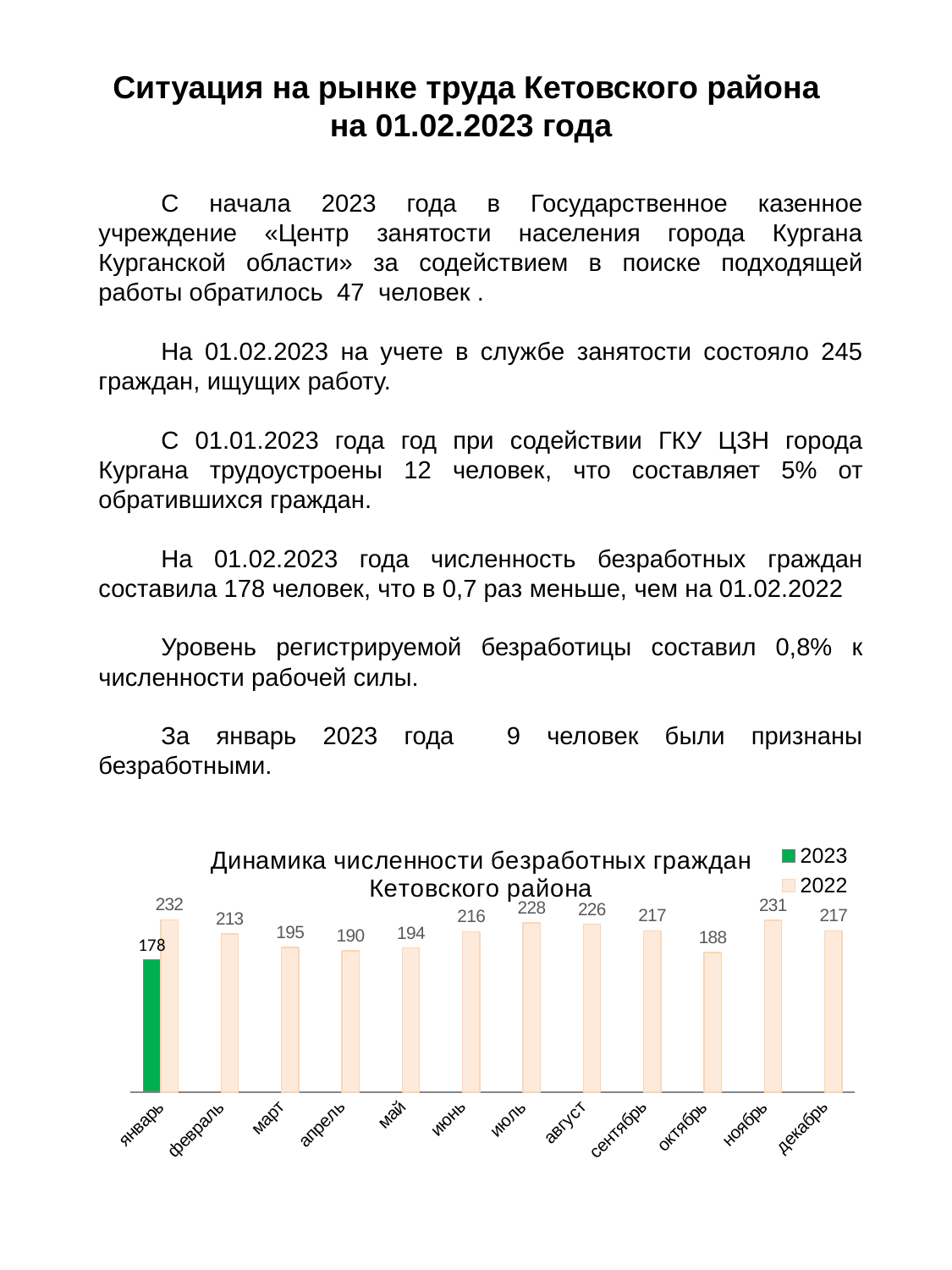
What is the value for 2022 in октябрь? 188 What kind of chart is shown? bar chart What is the value for 2022 in январь? 232 What is the value for 2022 in июль? 228 What is the difference between the 2022 values for ноябрь and декабрь? 14 How many series does the legend list? 2 What is the value for 2023 in январь? 178 Which is larger for 2022: апрель or июнь? июнь How many months are shown on the x axis? 12 What is the difference between the 2022 and 2023 values for январь? 54 Which series is shown in green? 2023 Which is larger for 2022: февраль or октябрь? февраль